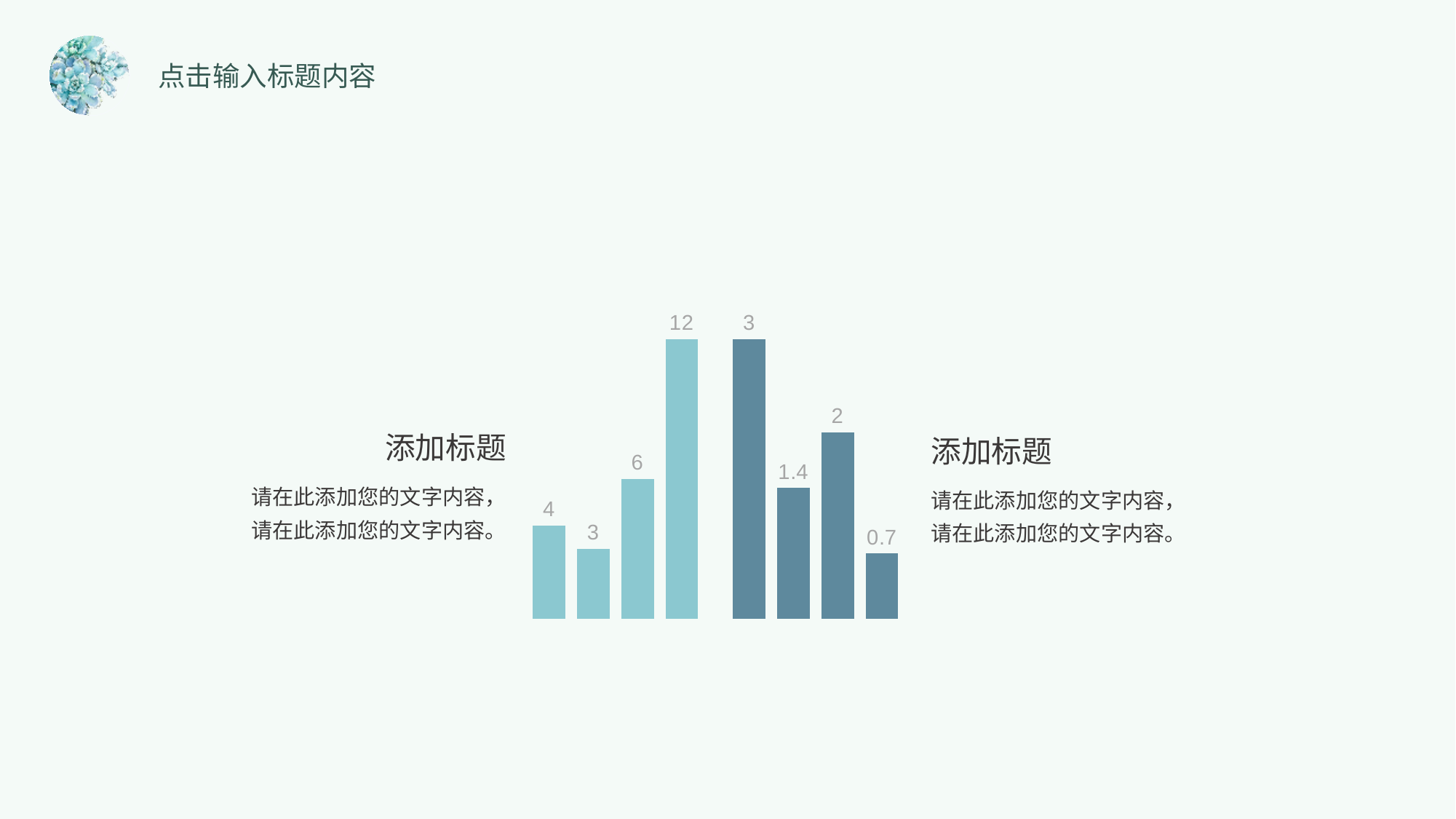
What is the value printed above the tallest light-coloured bar? 12 Among the dark-coloured bars, which value is the highest? 3 What kind of chart is shown on the slide? bar chart How many light-coloured bars are there in the left group of the chart? 4 What is the value printed above the second dark-coloured bar? 1.4 Which is larger: the third dark-coloured bar (2) or the second dark-coloured bar (1.4)? 2 Among the light-coloured bars, which value is the lowest? 3 How many bars are plotted in the chart? 8 What is the value printed above the first (leftmost) light-coloured bar? 4 What is the difference between the third and fourth light-coloured bars (6 and 12)? 6 What is the value printed above the last (rightmost) dark-coloured bar? 0.7